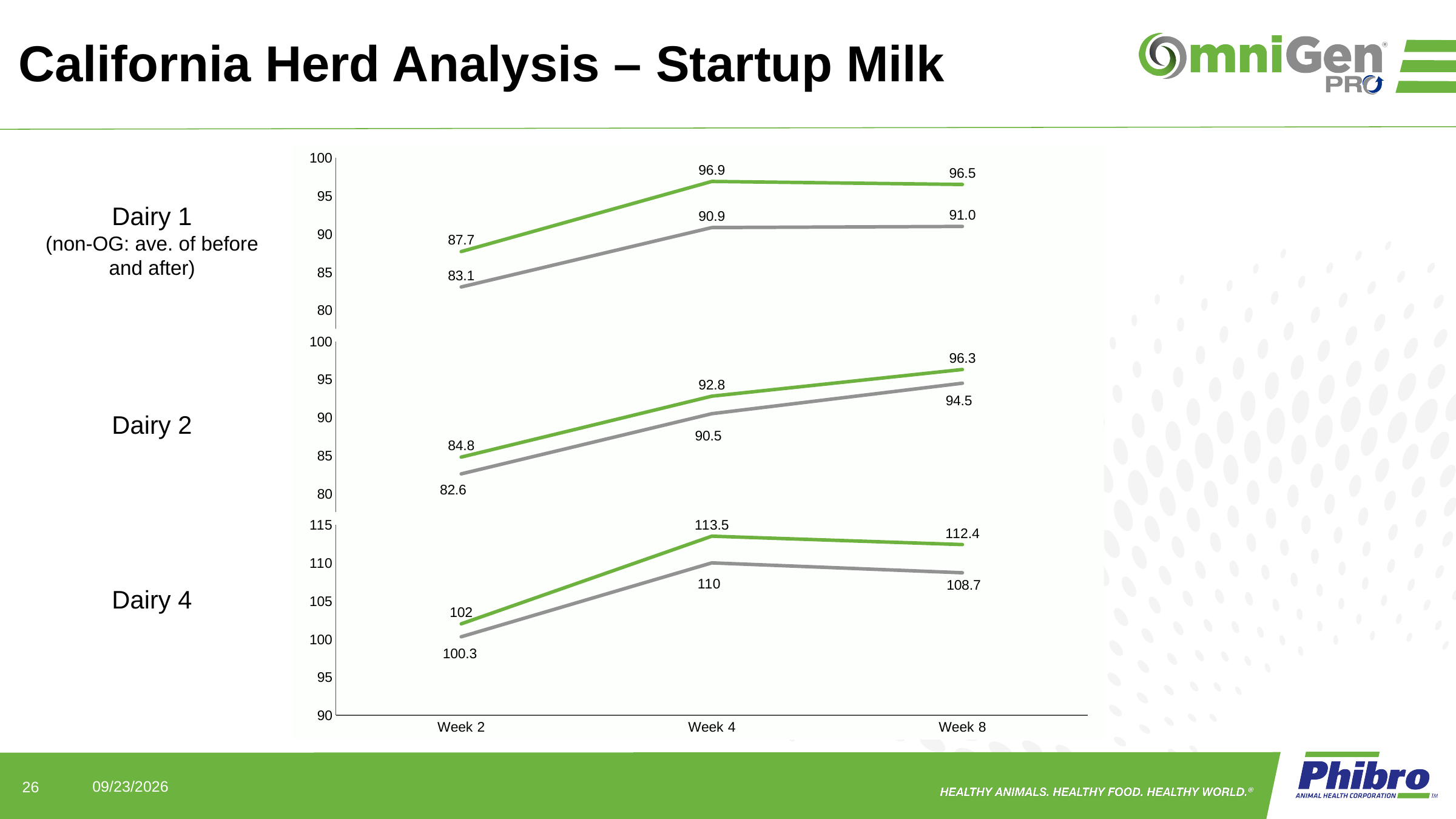
In the Dairy 1 chart, what is the value of the green line at Week 4? 96.9 In the Dairy 4 chart, what is the value of the gray line at Week 4? 110 In the Dairy 1 chart, which line has the larger value at Week 8, the green line or the gray line? green line In the Dairy 2 chart, does the gray line rise or fall from Week 2 to Week 8? rise In the Dairy 4 chart, by how much does the green line drop from Week 4 to Week 8? 1.1 What type of chart is used for Dairy 2? line chart In the Dairy 4 chart, at which week is the gray line lowest? Week 2 How many weeks are shown on the x axis of the charts? 3 In the Dairy 2 chart, what is the value of the green line at Week 8? 96.3 In the Dairy 2 chart, at which week does the green line reach its highest value? Week 8 In the Dairy 1 chart, what is the difference between the green line and the gray line at Week 2? 4.6 In the Dairy 1 chart, what is the value of the gray line at Week 2? 83.1